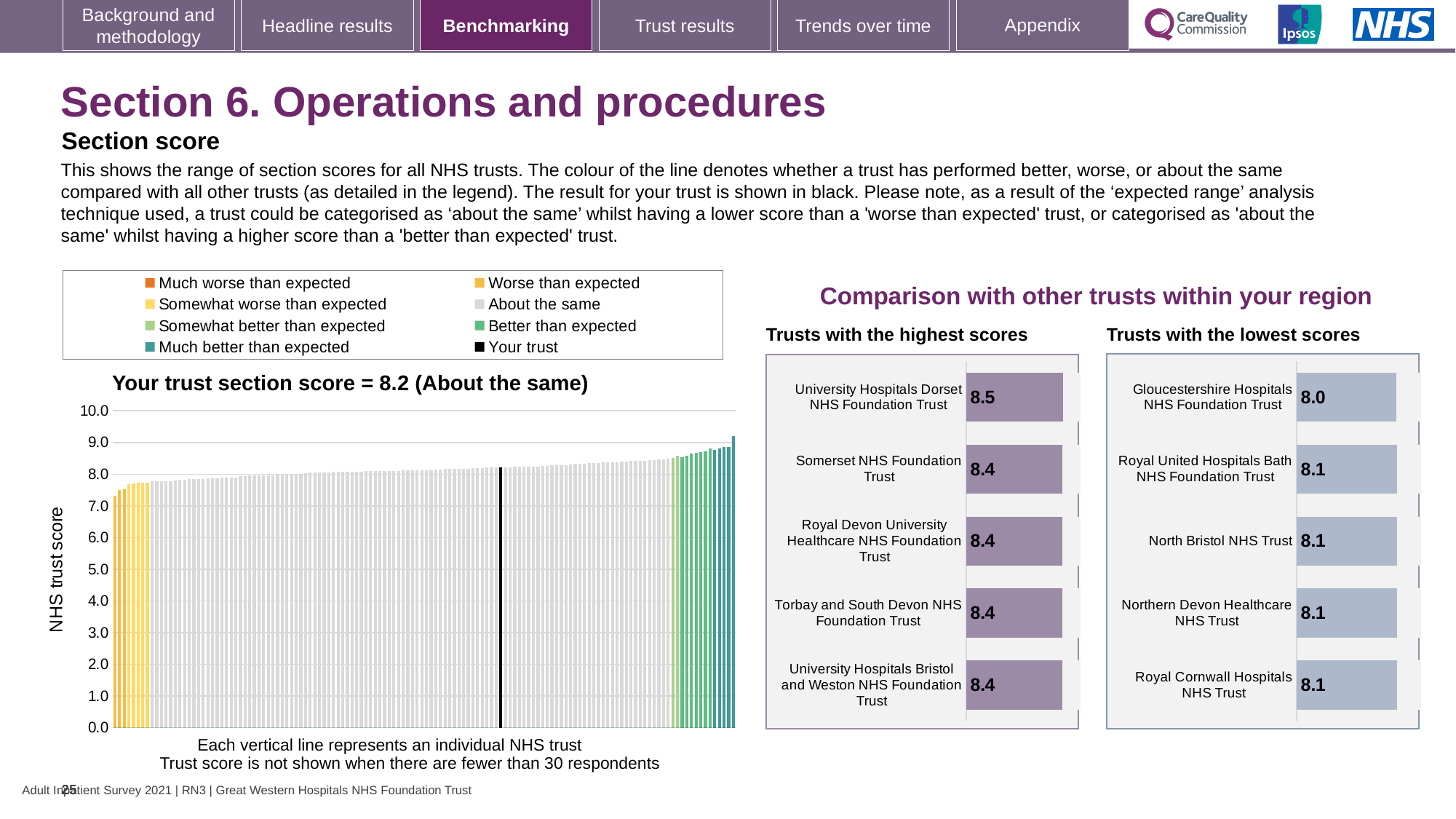
What kind of chart is the 'Your trust section score' chart? bar chart On the 'Trusts with the highest scores' chart, what is the score for University Hospitals Dorset NHS Foundation Trust? 8.5 On the 'Your trust section score' chart, is the value of the lowest-scoring trust greater or less than 7.0? greater How many trusts are shown on the 'Trusts with the lowest scores' chart? 5 On the 'Your trust section score' chart, which category does your trust fall into? About the same On the 'Trusts with the highest scores' chart, which trust has the highest score? University Hospitals Dorset NHS Foundation Trust On the 'Trusts with the lowest scores' chart, which trust has the lowest score? Gloucestershire Hospitals NHS Foundation Trust On the 'Your trust section score' chart, what is the section score for your trust? 8.2 What is the label on the vertical axis of the 'Your trust section score' chart? NHS trust score How many entries does the legend above the 'Your trust section score' chart list? 8 On the 'Your trust section score' chart, do the trust scores rise or fall from left to right? rise What is the difference between the score for University Hospitals Dorset NHS Foundation Trust on the 'Trusts with the highest scores' chart and the score for Gloucestershire Hospitals NHS Foundation Trust on the 'Trusts with the lowest scores' chart? 0.5